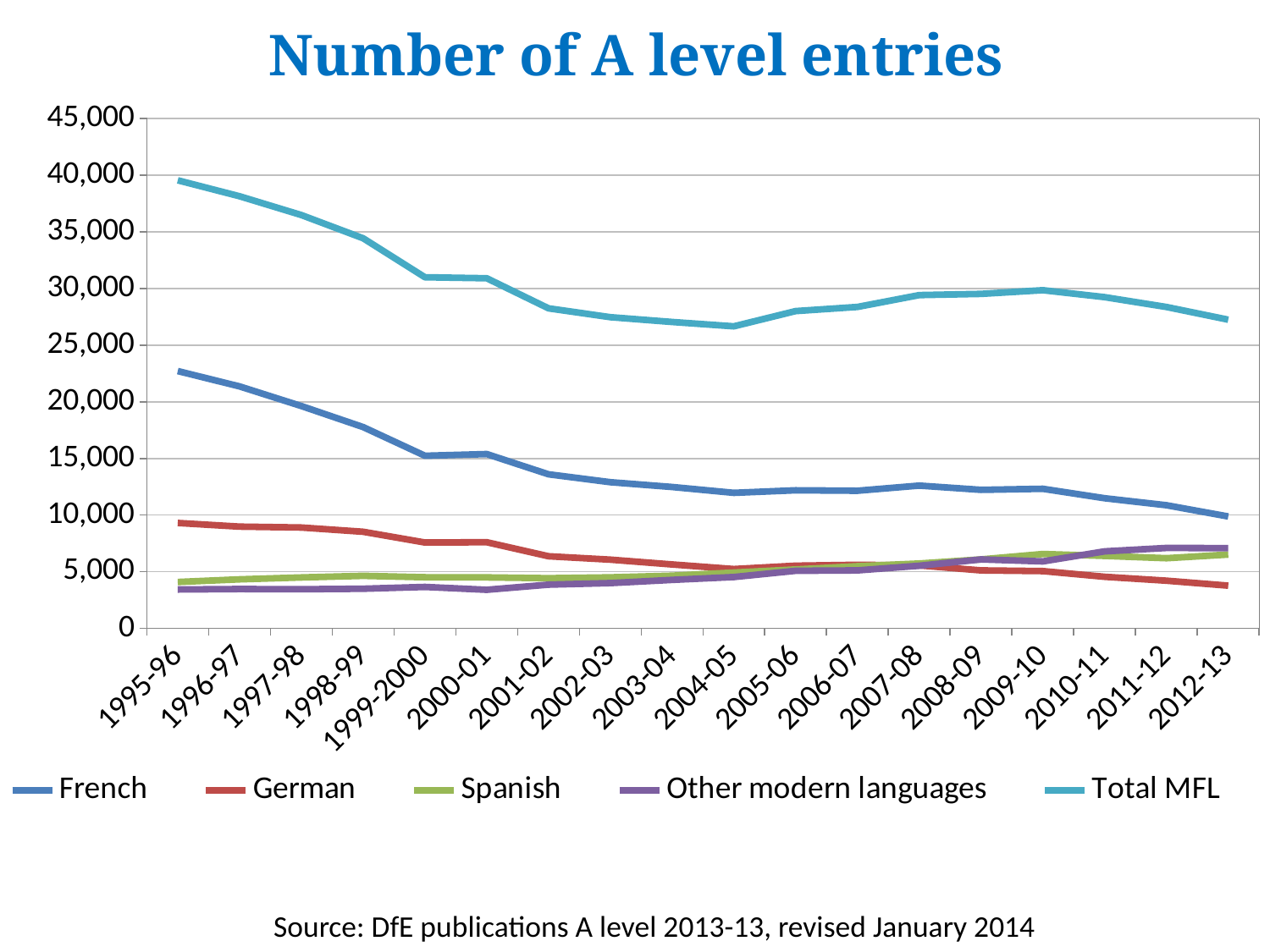
Is the value for Total MFL in 2004-05 greater or less than 30,000? less Does the number of French A level entries rise or fall overall from 1995-96 to 2012-13? fall How many series does the legend list? 5 Which series has the lowest value in 2012-13? German What kind of chart is shown on the slide? line chart Is the value for Total MFL in 1995-96 greater or less than 35,000? greater Which series has the highest value in 1995-96? Total MFL How many academic years are shown along the x axis? 18 Is the value for French in 1995-96 greater or less than 20,000? greater In 2012-13, which has more entries, Spanish or German? Spanish What is the title of the chart? Number of A level entries